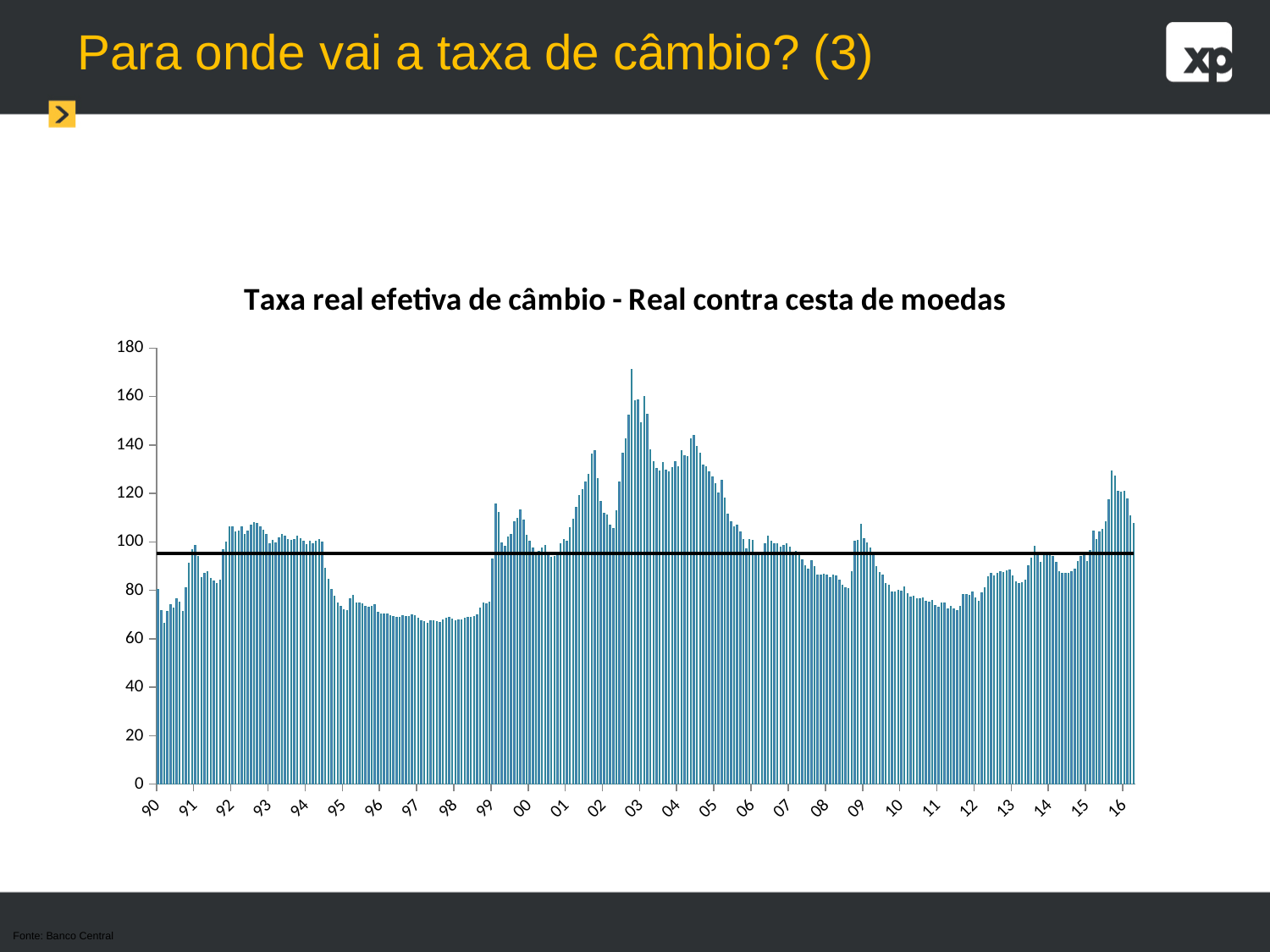
How many year labels are shown along the x axis? 27 Do the values rise or fall between the year labels 09 and 11? fall Do the values rise or fall between the year labels 14 and 16? rise Are the bars around the year label 98 greater or less than 80? less Are the bars around the year label 05 greater or less than 100? greater Are the bars around the year label 11 greater or less than 80? less What is the highest value shown on the y axis? 180 Around which year label does the highest bar in the chart occur? 03 Which is larger: the peak of bars around 03 or the peak of bars around 16? 03 What is the title of the chart? Taxa real efetiva de câmbio - Real contra cesta de moedas What kind of chart is shown on the slide? bar chart